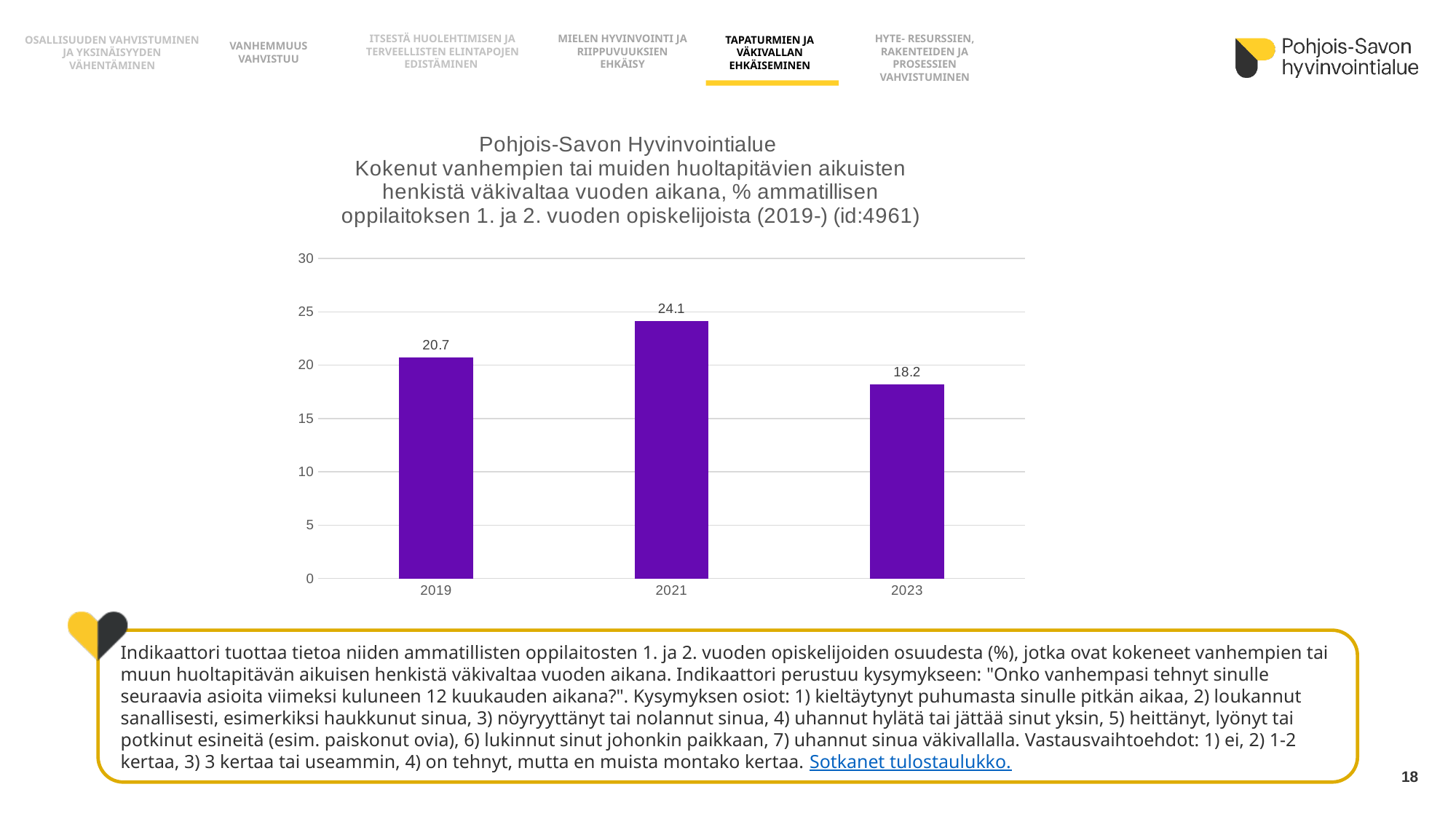
Which year has the highest value? 2021 Is the value for 2023 greater or less than 20? less What is the value for 2023? 18.2 What is the value for 2019? 20.7 What colour are the bars in the chart? purple Which year has the lowest value? 2023 What is the difference between the values for 2019 and 2021? 3.4 What is the difference between the values for 2021 and 2023? 5.9 What is the value for 2021? 24.1 How many years are shown on the x axis? 3 What kind of chart is shown on the slide? bar chart Which is larger, the value for 2019 or the value for 2023? 2019